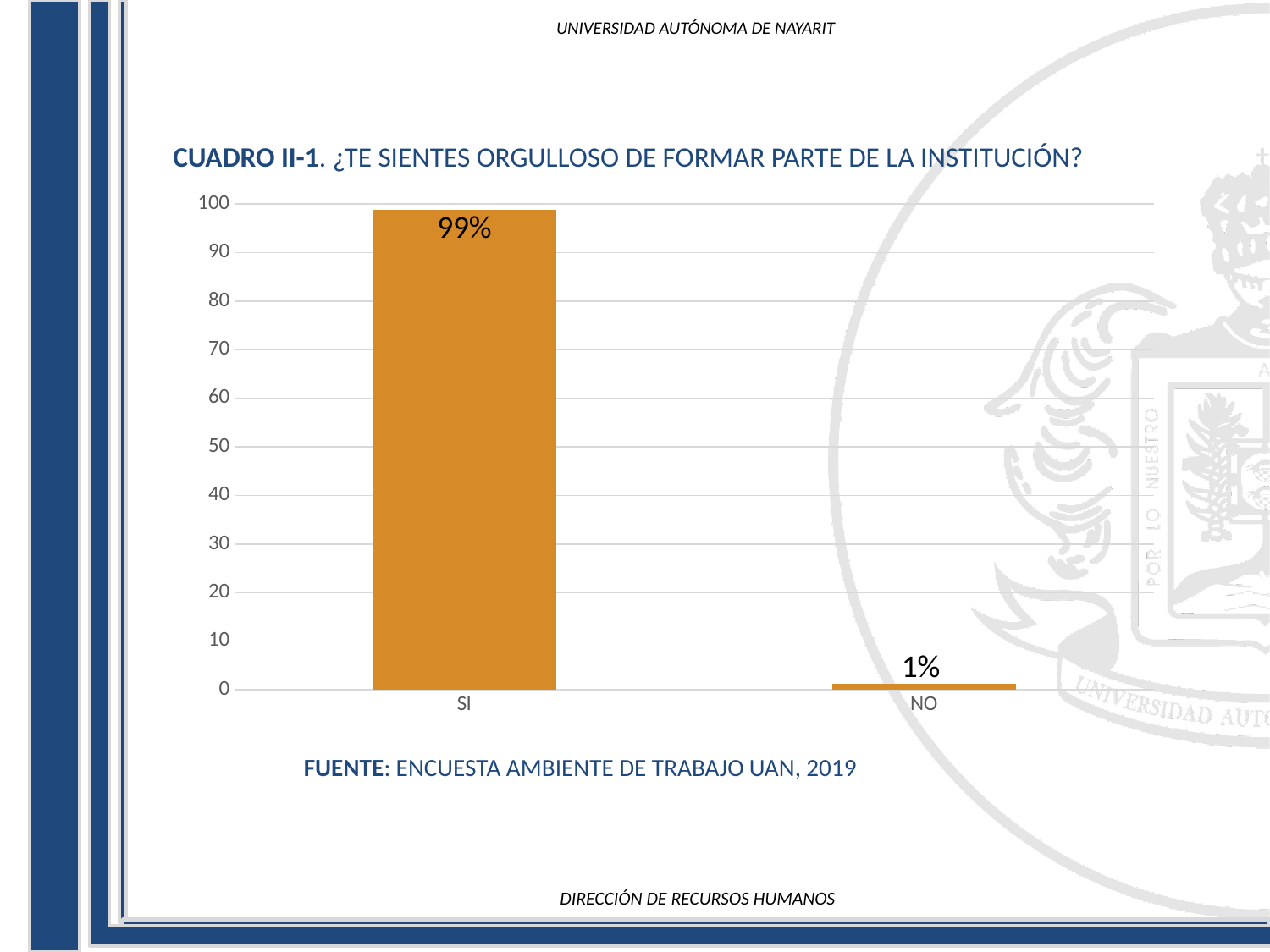
Is the value for NO greater or less than 10? less What is the value for NO? 1% Which category has the highest value? SI Which is larger, the value for SI or the value for NO? SI What kind of chart is shown on the slide? bar chart What is the source cited below the chart? ENCUESTA AMBIENTE DE TRABAJO UAN, 2019 What is the highest value shown on the y axis? 100 Is the value for SI greater or less than 90? greater What is the difference between the values for SI and NO? 98% Which category has the lowest value? NO How many categories are shown on the x axis? 2 What is the value for SI? 99%